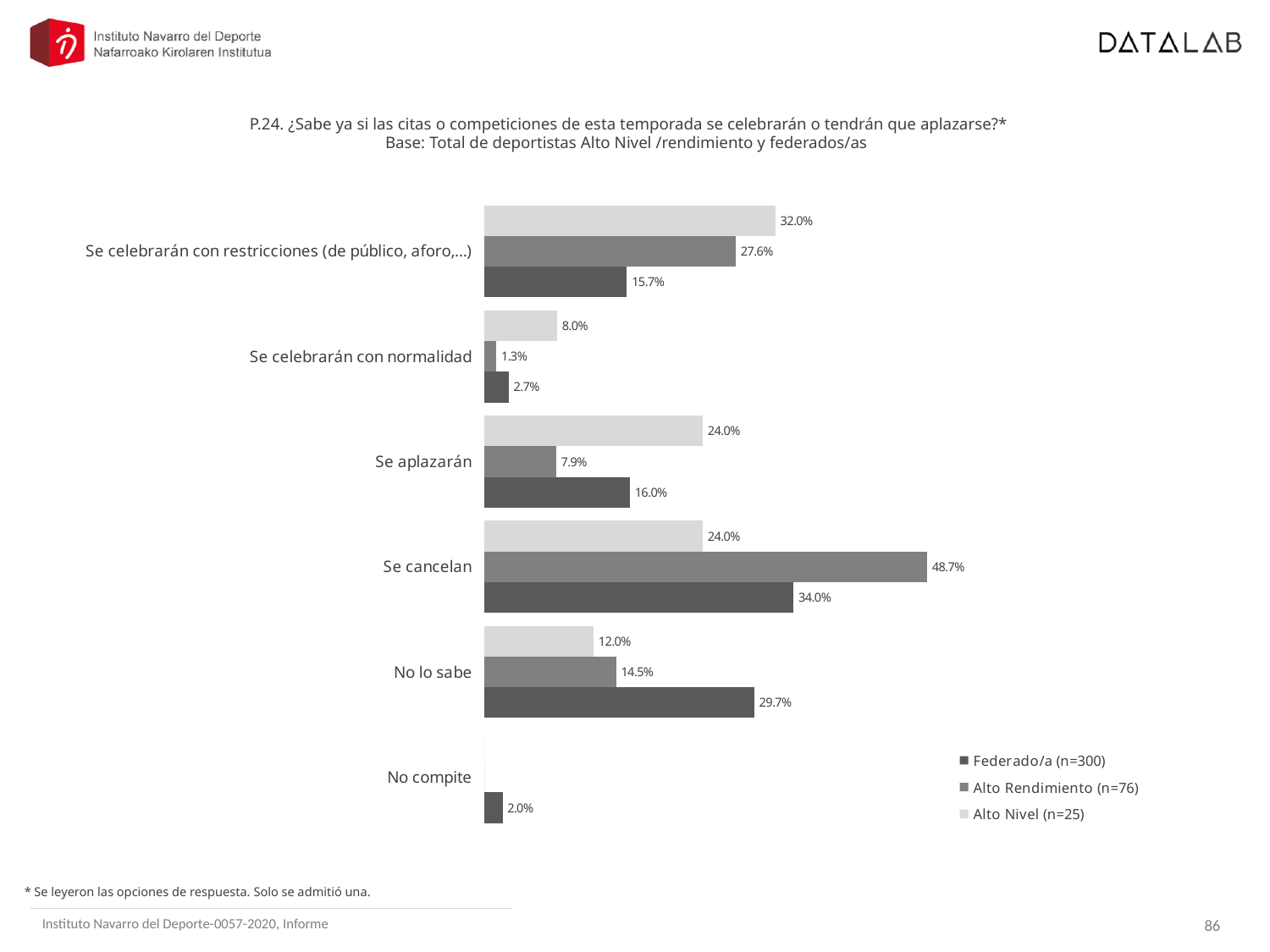
What is the value for Alto Rendimiento (n=76) in the 'Se cancelan' category? 48.7% In the 'Se aplazarán' category, which is larger: the value for Alto Nivel (n=25) or for Federado/a (n=300)? Alto Nivel (n=25) What is the value for Federado/a (n=300) in the 'No compite' category? 2.0% Which category has the lowest value for the Alto Rendimiento (n=76) series among those with a labelled bar? Se celebrarán con normalidad What is the value for Federado/a (n=300) in the 'No lo sabe' category? 29.7% Which series is shown with the darkest bars? Federado/a (n=300) What is the difference between the Alto Rendimiento (n=76) and Federado/a (n=300) values in the 'Se cancelan' category? 14.7% Which category has the highest value for the Federado/a (n=300) series? Se cancelan What kind of chart is shown on the slide? bar chart How many series does the legend list? 3 What is the value for Alto Nivel (n=25) in the 'Se celebrarán con restricciones (de público, aforo,...)' category? 32.0% How many response categories are shown on the chart? 6